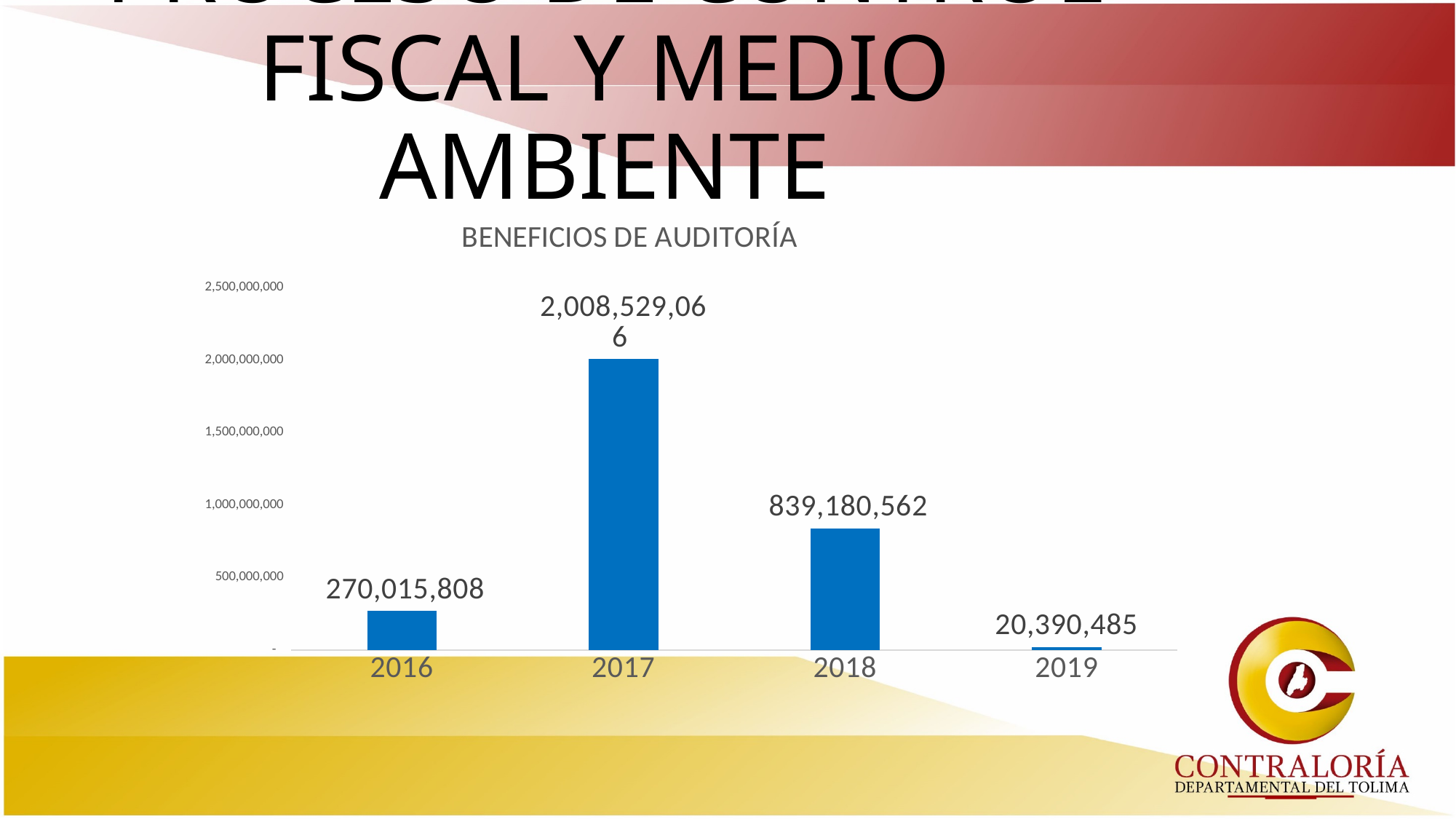
What is the difference between the values for 2016 and 2019? 249,625,323 What is the value for 2019? 20,390,485 What is the title of the chart? BENEFICIOS DE AUDITORÍA Is the value for 2018 greater or less than 500,000,000? greater What is the value for 2017? 2,008,529,066 Which is larger, the value for 2016 or the value for 2018? 2018 How many years are shown on the x axis? 4 What is the value for 2018? 839,180,562 What is the difference between the values for 2017 and 2018? 1,169,348,504 What is the value for 2016? 270,015,808 Which year has the highest value? 2017 Which year has the lowest value? 2019